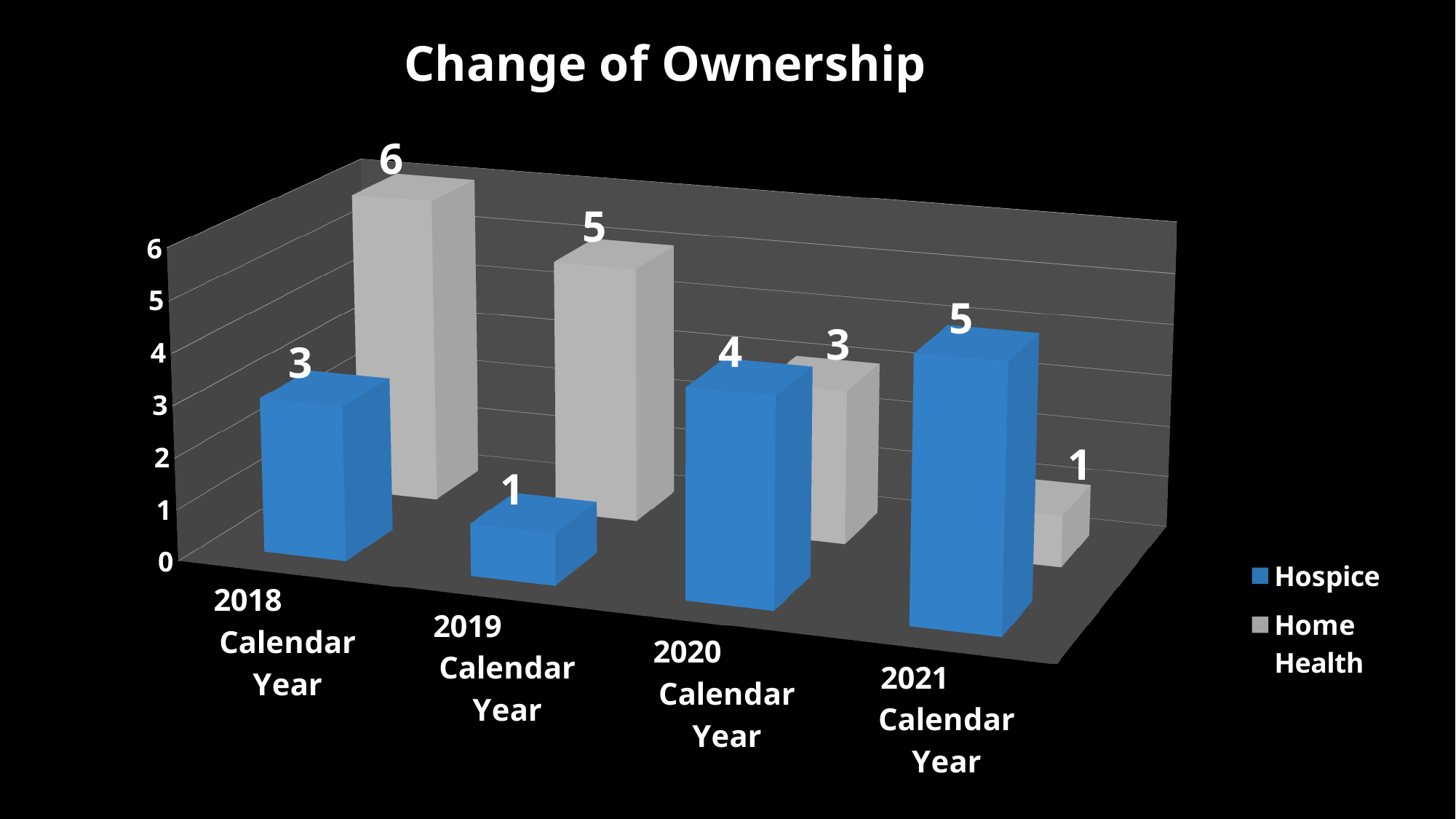
Which calendar year has the highest Home Health value? 2018 Calendar Year What kind of chart is shown on the slide? Bar chart What is the Hospice value for the 2018 Calendar Year? 3 What is the Home Health value for the 2021 Calendar Year? 1 How many calendar years are shown on the x axis? 4 What is the difference between the Home Health and Hospice values for the 2018 Calendar Year? 3 Which calendar year has the lowest Hospice value? 2019 Calendar Year Which is larger for the 2020 Calendar Year, Hospice or Home Health? Hospice How many series does the legend list? 2 What is the title of the chart? Change of Ownership What is the Hospice value for the 2021 Calendar Year? 5 What is the Home Health value for the 2019 Calendar Year? 5